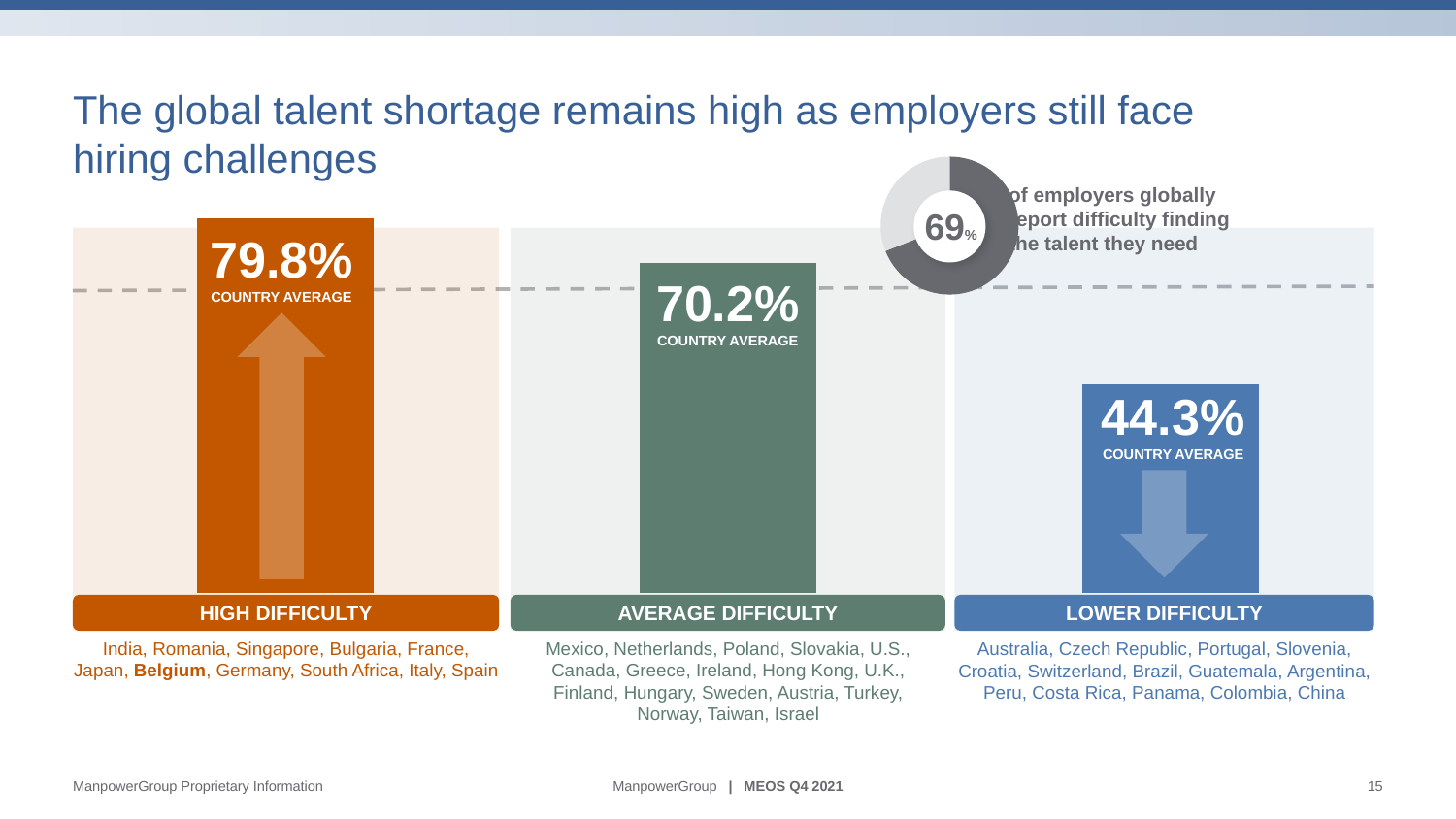
How many difficulty groups are shown in the bar chart? 3 What is the country average for the Lower Difficulty group? 44.3% What is the country average for the Average Difficulty group? 70.2% What percentage of employers globally report difficulty finding the talent they need, according to the donut chart? 69% Which is larger, the Average Difficulty country average or the Lower Difficulty country average? Average Difficulty Which difficulty group has the highest country average? High Difficulty What is the country average for the High Difficulty group? 79.8% Which difficulty group has the lowest country average? Lower Difficulty What colour is the High Difficulty bar? orange What is the difference between the High Difficulty and Lower Difficulty country averages? 35.5% What is the difference between the High Difficulty and Average Difficulty country averages? 9.6% Do the country averages rise or fall from the High Difficulty bar to the Lower Difficulty bar? fall